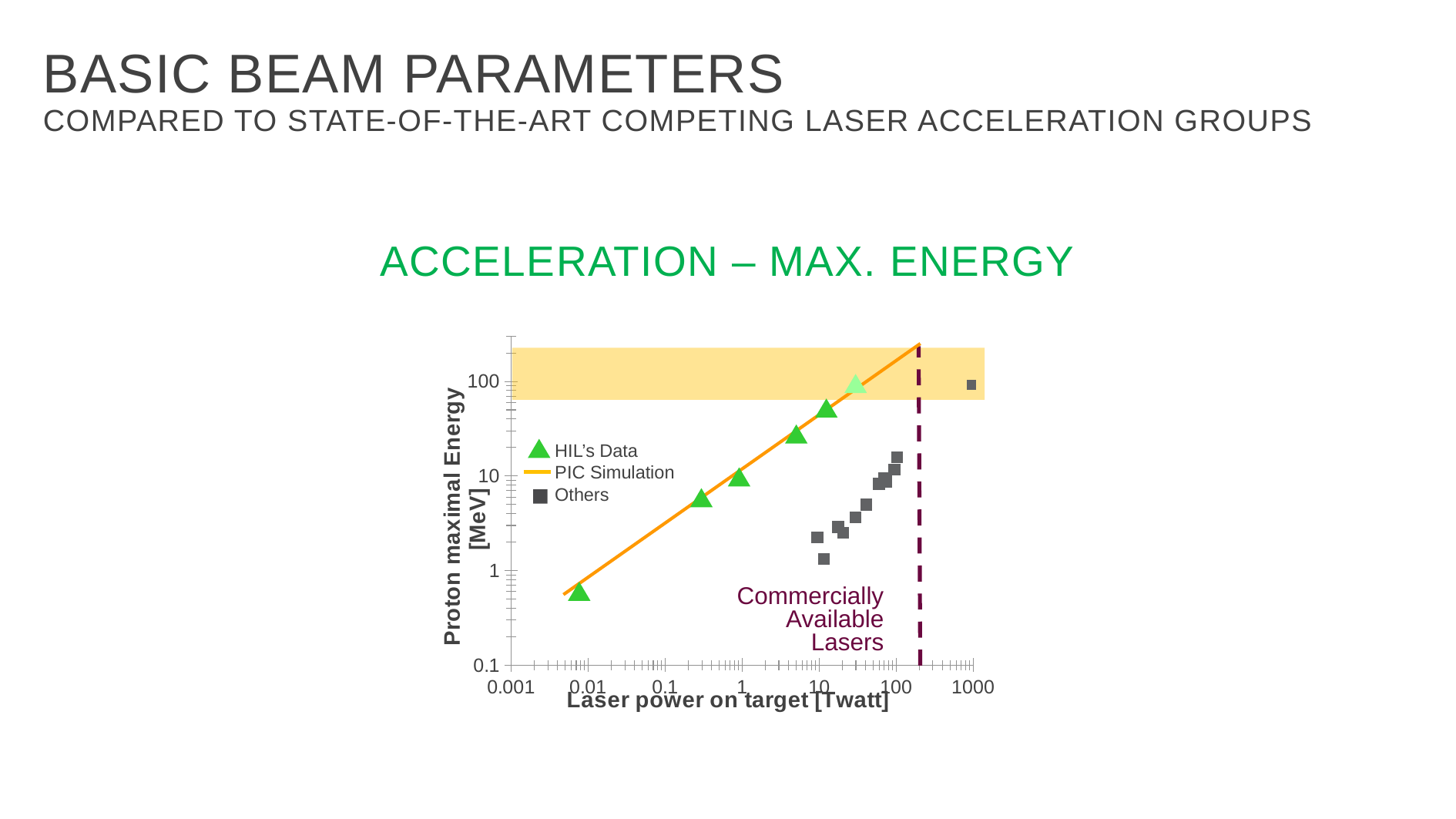
Which series has the lowest plotted proton maximal energy on the chart? HIL's Data How many series does the legend list? 3 What is the label of the y axis? Proton maximal Energy [MeV] What is the label of the x axis? Laser power on target [Twatt] What are the three series named in the legend? HIL's Data, PIC Simulation, Others Is the proton maximal energy of the Others point at about 1000 Twatt greater or less than 10 MeV? greater Do the HIL's Data values rise or fall as laser power on target increases? Rise How many HIL's Data points (green triangles) are plotted? 6 Is the proton maximal energy of the lowest-power HIL's Data point greater or less than 1 MeV? less What kind of chart is shown on the slide? Scatter chart (with a simulation line) Is the proton maximal energy of the highest-power HIL's Data point greater or less than 10 MeV? greater